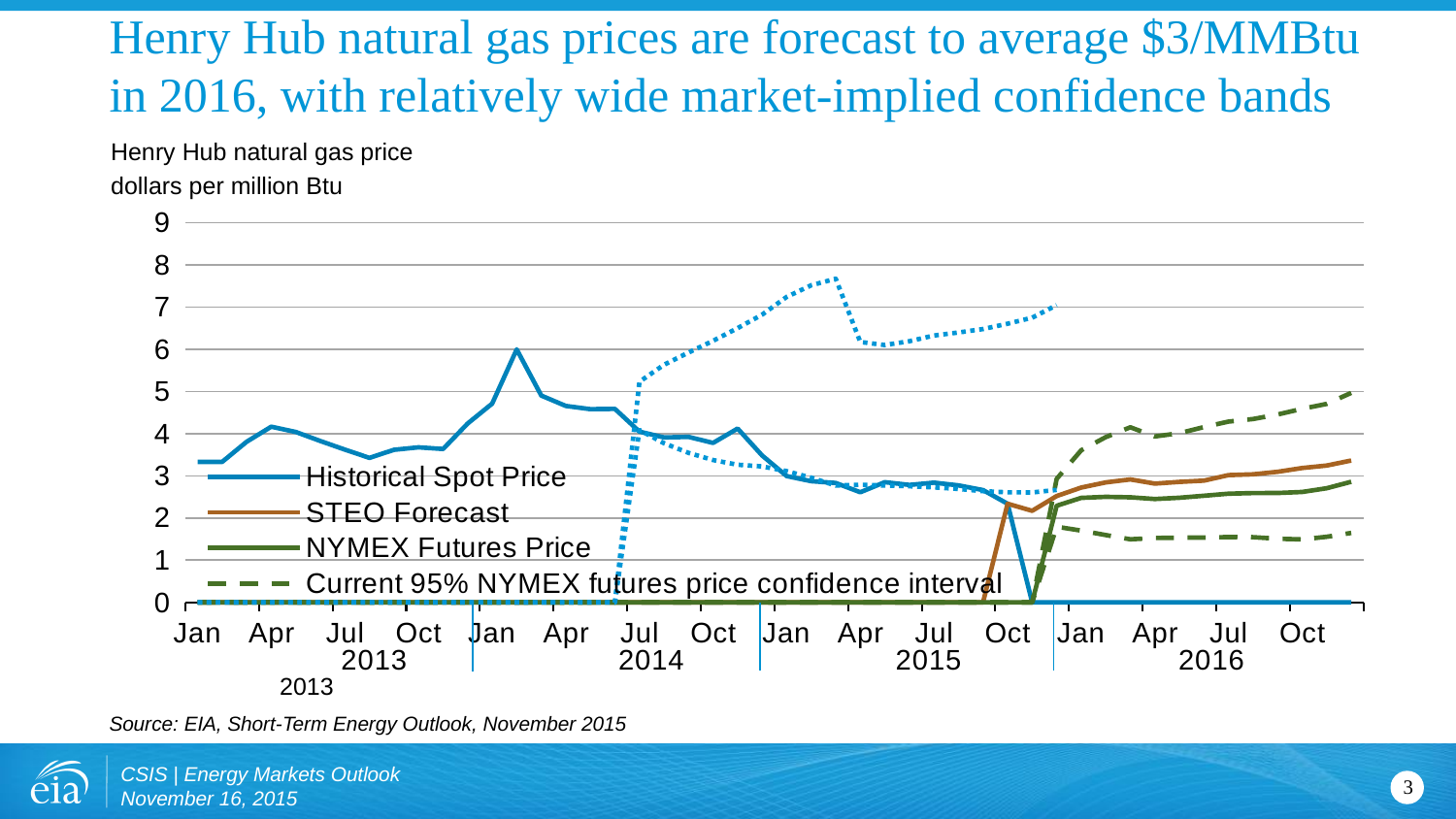
What kind of chart is shown on the slide? line chart Is the Historical Spot Price in Jan 2013 greater or less than 4? less Is the lower line of the 95% NYMEX futures price confidence interval at the end of 2016 greater or less than 2? less At the end of 2016, which is higher: the STEO Forecast or the NYMEX Futures Price? STEO Forecast What unit is the Henry Hub natural gas price plotted in? dollars per million Btu Is the upper line of the 95% NYMEX futures price confidence interval at the end of 2016 greater or less than 4? greater How many series does the chart legend list? 4 Does the STEO Forecast rise or fall over the course of 2016? rise How many years are labeled along the x axis? 4 Which series is drawn as a dashed line in the legend? Current 95% NYMEX futures price confidence interval